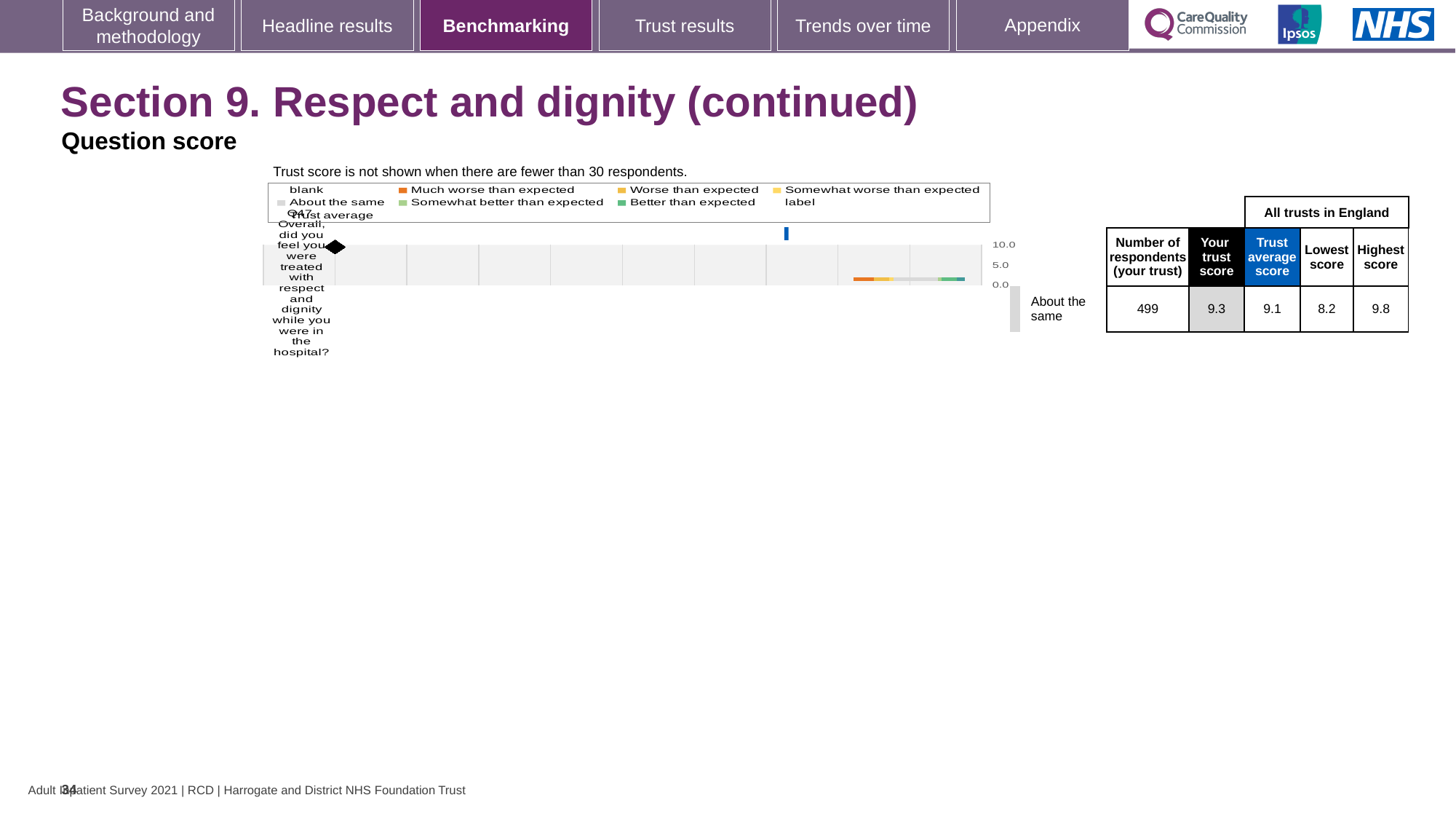
Which is larger for Q47: the trust score or the trust average score? trust score According to the table next to the chart, what is the trust score for Q47? 9.3 Is the trust average marker for Q47 greater or less than 5.0 on the score axis? greater According to the table next to the chart, what is the trust average score for Q47? 9.1 What kind of chart is shown on the slide? bar chart Which legend entry is shown in orange? Much worse than expected What is the difference between the highest score and the lowest score for Q47 in the table? 1.6 How many entries does the chart legend list? 9 What is the highest value shown on the chart's score axis? 10.0 According to the table next to the chart, what is the highest score among all trusts in England for Q47? 9.8 According to the table next to the chart, how many respondents answered Q47 for this trust? 499 How many questions (categories) are plotted on the chart? 1